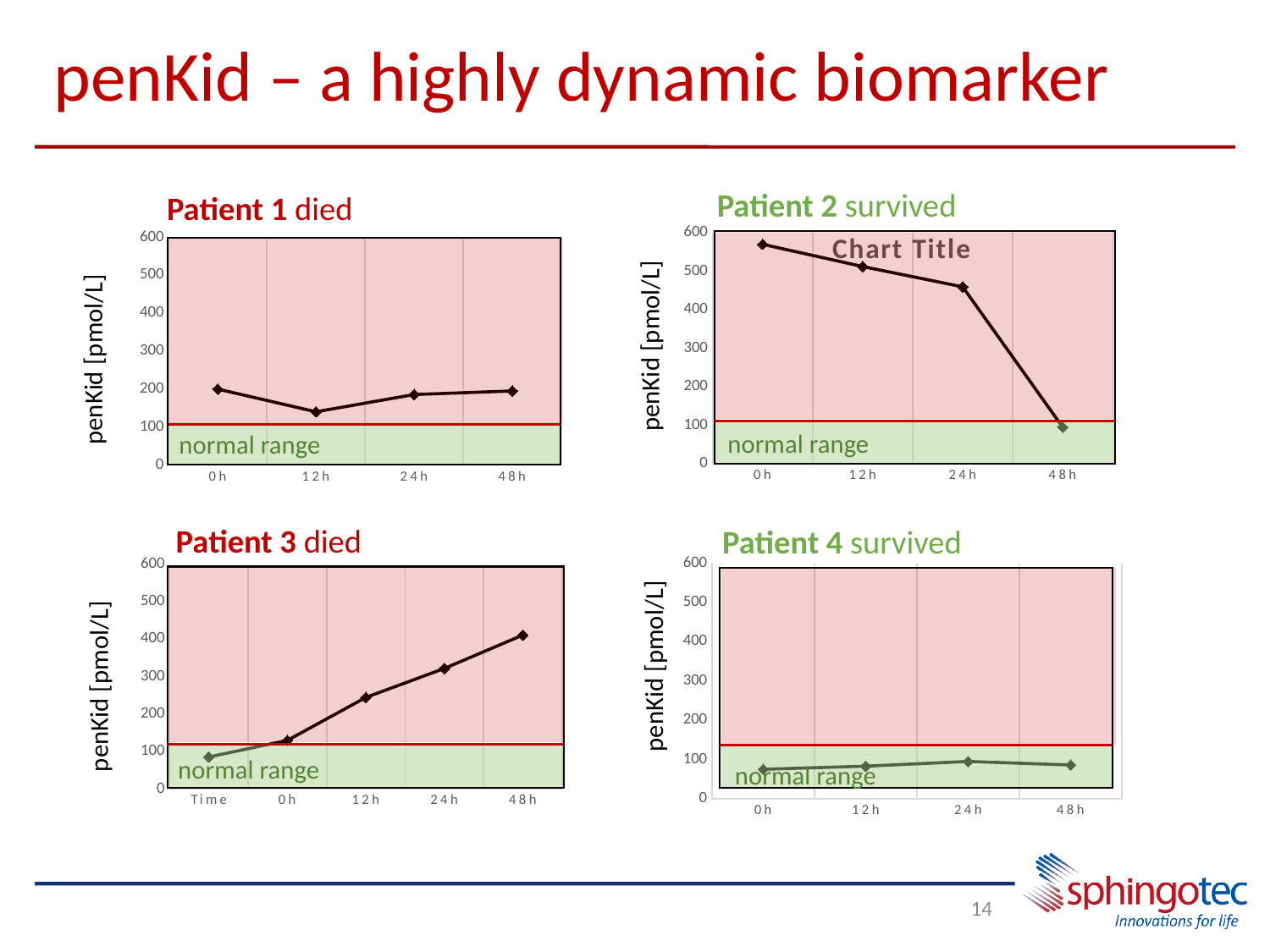
In the 'Patient 2 survived' chart, which time point has the highest value? 0h How many data points are plotted in the 'Patient 3 died' chart? 5 What is the y-axis label on the 'Patient 1 died' chart? penKid [pmol/L] In the 'Patient 3 died' chart, which time point has the highest value? 48h In the 'Patient 2 survived' chart, do the values rise or fall from 0h to 48h? fall In the 'Patient 4 survived' chart, is the value at 0h greater or less than 100? less In the 'Patient 3 died' chart, do the values rise or fall along the x axis? rise In the 'Patient 2 survived' chart, which time point has the lowest value? 48h In the 'Patient 3 died' chart, is the value at 48h greater or less than 300? greater In the 'Patient 1 died' chart, which time point has the lowest value? 12h What kind of chart is the 'Patient 1 died' chart? line chart